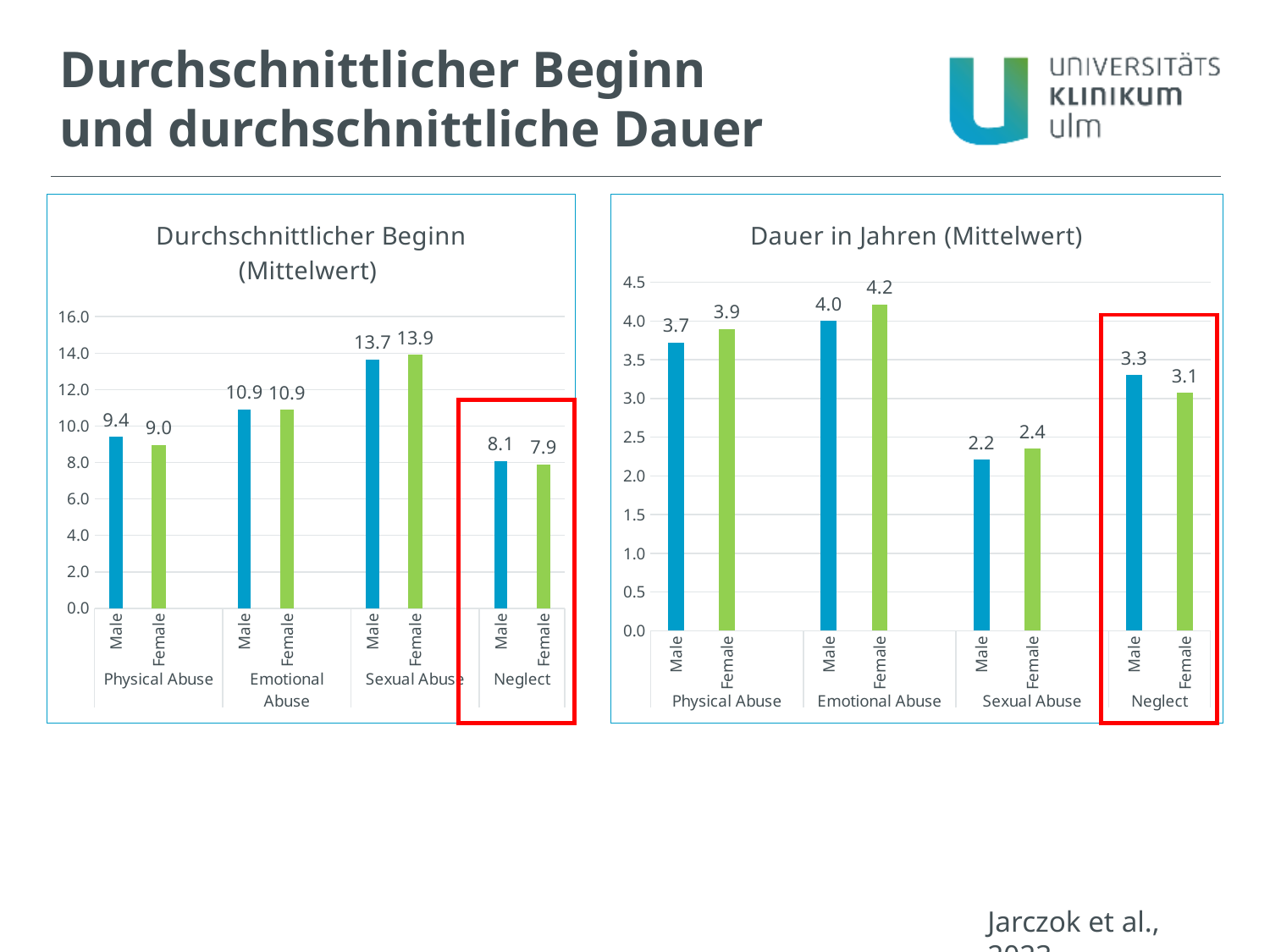
In the 'Dauer in Jahren (Mittelwert)' chart, what is the value for Male under Sexual Abuse? 2.2 In the 'Durchschnittlicher Beginn (Mittelwert)' chart, what is the difference between the Male and Female values under Neglect? 0.2 In the 'Durchschnittlicher Beginn (Mittelwert)' chart, how many bars are plotted? 8 Which category group is highlighted with a red box in both charts? Neglect In the 'Dauer in Jahren (Mittelwert)' chart, is the value for Male under Neglect greater or less than 3.0? greater In the 'Dauer in Jahren (Mittelwert)' chart, which bar has the highest value? Female, Emotional Abuse In the 'Durchschnittlicher Beginn (Mittelwert)' chart, what is the value for Female under Sexual Abuse? 13.9 In the 'Dauer in Jahren (Mittelwert)' chart, which is larger: the Male value under Physical Abuse or the Female value under Physical Abuse? Female under Physical Abuse In the 'Dauer in Jahren (Mittelwert)' chart, what is the value for Female under Emotional Abuse? 4.2 In the 'Durchschnittlicher Beginn (Mittelwert)' chart, which bar has the lowest value? Female, Neglect In the 'Durchschnittlicher Beginn (Mittelwert)' chart, what is the value for Male under Physical Abuse? 9.4 What kind of chart is the 'Dauer in Jahren (Mittelwert)' chart? Bar chart